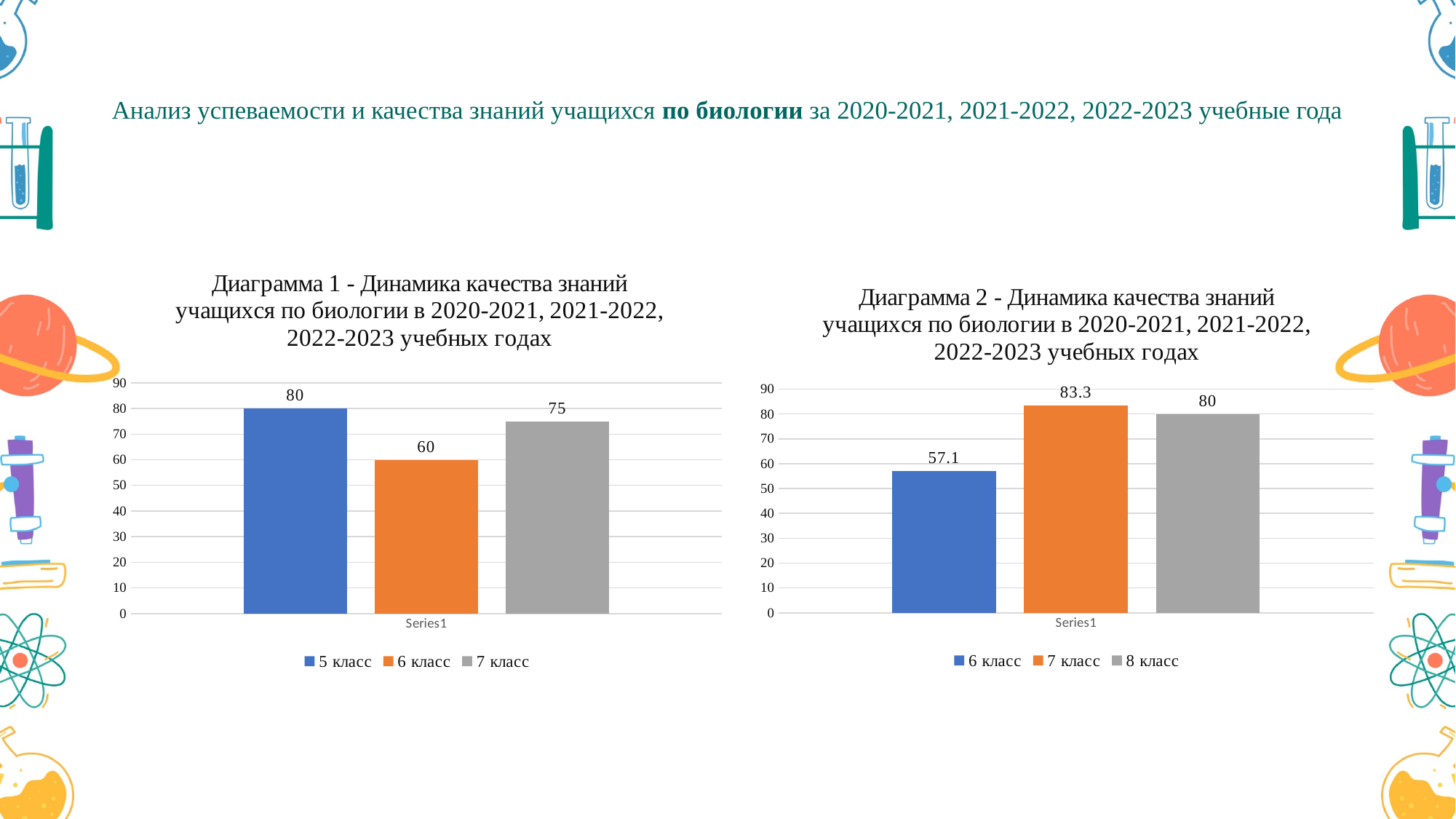
In Диаграмма 2 (right chart), what is the difference between the values for 7 класс and 6 класс? 26.2 What kind of chart is Диаграмма 2 (right chart)? Bar chart In Диаграмма 1 (left chart), what is the difference between the values for 5 класс and 7 класс? 5 In Диаграмма 1 (left chart), which series has the lowest value? 6 класс In Диаграмма 1 (left chart), what is the value for 6 класс? 60 In Диаграмма 2 (right chart), which series has the highest value? 7 класс In Диаграмма 1 (left chart), how many series does the legend list? 3 In Диаграмма 1 (left chart), what colour is the bar for 7 класс? Grey In Диаграмма 2 (right chart), which is larger, the value for 6 класс or the value for 8 класс? 8 класс In Диаграмма 1 (left chart), what is the value for 5 класс? 80 In Диаграмма 2 (right chart), what is the value for 6 класс? 57.1 In Диаграмма 2 (right chart), what is the value for 7 класс? 83.3